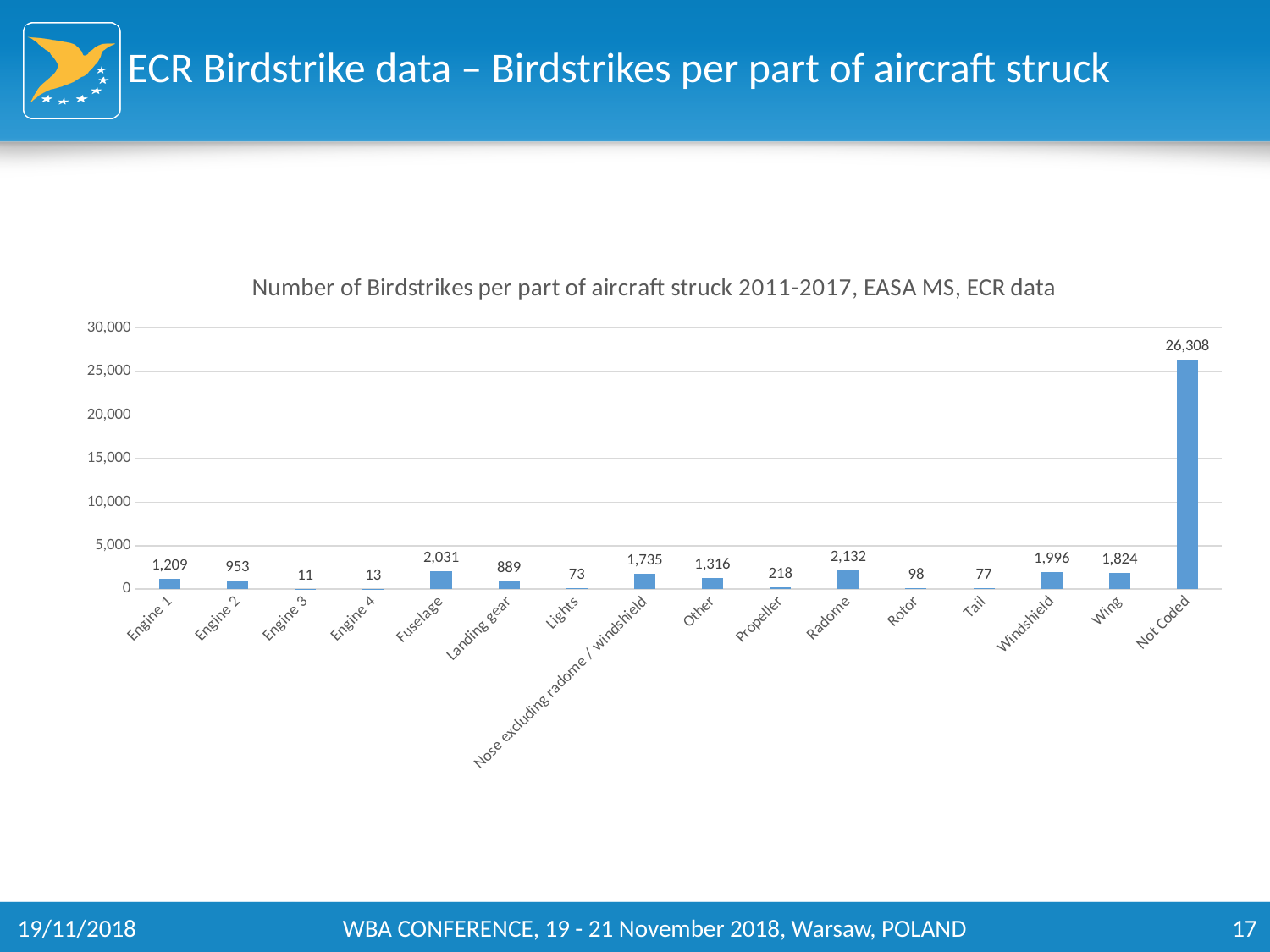
What is the number of birdstrikes for Not Coded? 26,308 Is the value for Not Coded greater or less than 25,000? greater What is the title of the chart? Number of Birdstrikes per part of aircraft struck 2011-2017, EASA MS, ECR data What is the difference between the number of birdstrikes for Windshield and Wing? 172 What kind of chart is shown on the slide? Bar chart Which has more birdstrikes, Engine 1 or Engine 2? Engine 1 Which category has the lowest number of birdstrikes? Engine 3 What is the number of birdstrikes for Radome? 2,132 How many categories are shown on the x axis? 16 What is the number of birdstrikes for Nose excluding radome / windshield? 1,735 What is the difference between the number of birdstrikes for Fuselage and Landing gear? 1,142 Which part of aircraft has the highest number of birdstrikes? Not Coded